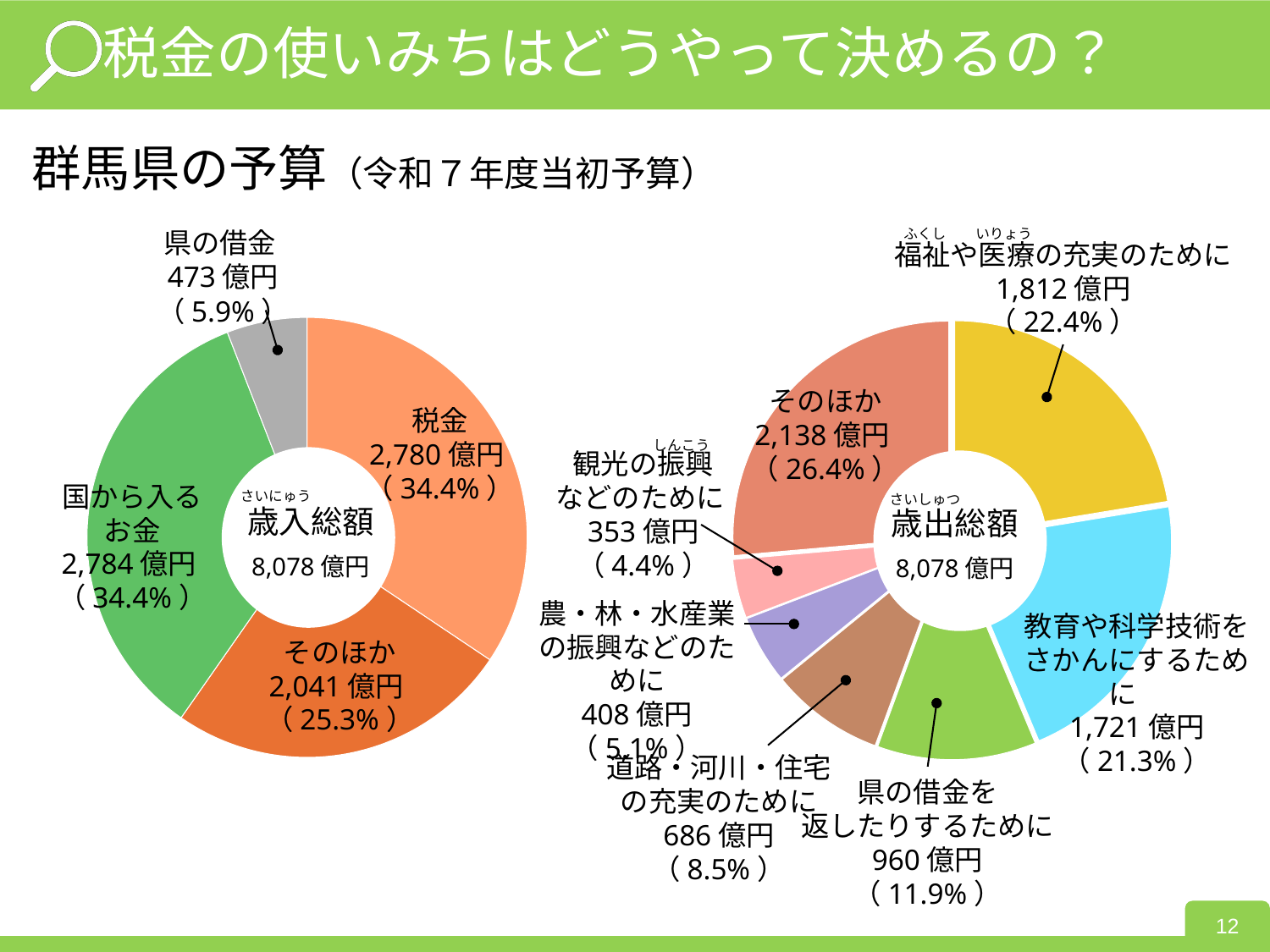
In the 歳入総額 chart on the left, what is the difference between 税金 and 県の借金? 2,307 億円 In the 歳出総額 chart on the right, what is the difference between 福祉や医療の充実のために and 教育や科学技術をさかんにするために? 91 億円 In the 歳入総額 chart on the left, what is the value for 税金? 2,780 億円 In the 歳入総額 chart on the left, what percentage share does 国から入るお金 have? 34.4% What kind of chart is used on this slide? pie chart (donut) In the 歳出総額 chart on the right, which is larger: 県の借金を返したりするために or 道路・河川・住宅の充実のために? 県の借金を返したりするために What total amount is shown in the centre of the 歳出総額 chart on the right? 8,078 億円 In the 歳出総額 chart on the right, which category is the largest? そのほか In the 歳出総額 chart on the right, what is the value for 福祉や医療の充実のために? 1,812 億円 In the 歳入総額 chart on the left, how many categories are shown? 4 In the 歳出総額 chart on the right, how many categories are shown? 7 In the 歳入総額 chart on the left, which category is the smallest? 県の借金